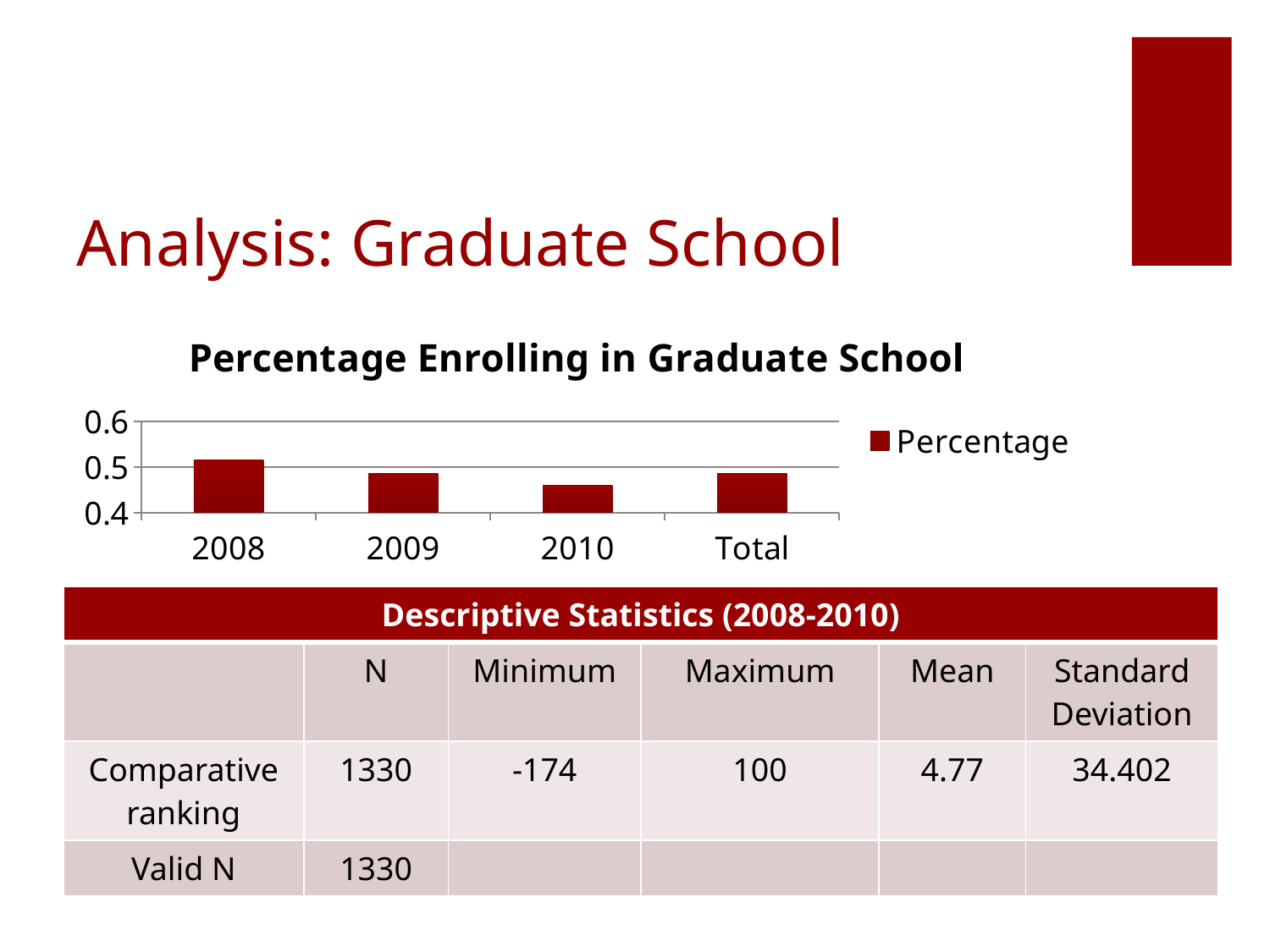
Which is larger, the value for 2009 or the value for 2010? 2009 What is the title of the chart? Percentage Enrolling in Graduate School What series name appears in the chart's legend? Percentage Do the values rise or fall from 2008 to 2010? fall Is the value for 2008 greater or less than 0.5? greater How many categories are shown on the x axis of the chart? 4 Which category has the lowest bar in the chart? 2010 Which category has the highest bar in the chart? 2008 Which is larger, the value for 2008 or the value for 2010? 2008 How many series does the chart's legend list? 1 What kind of chart is shown on the slide? bar chart Is the value for 2010 greater or less than 0.5? less